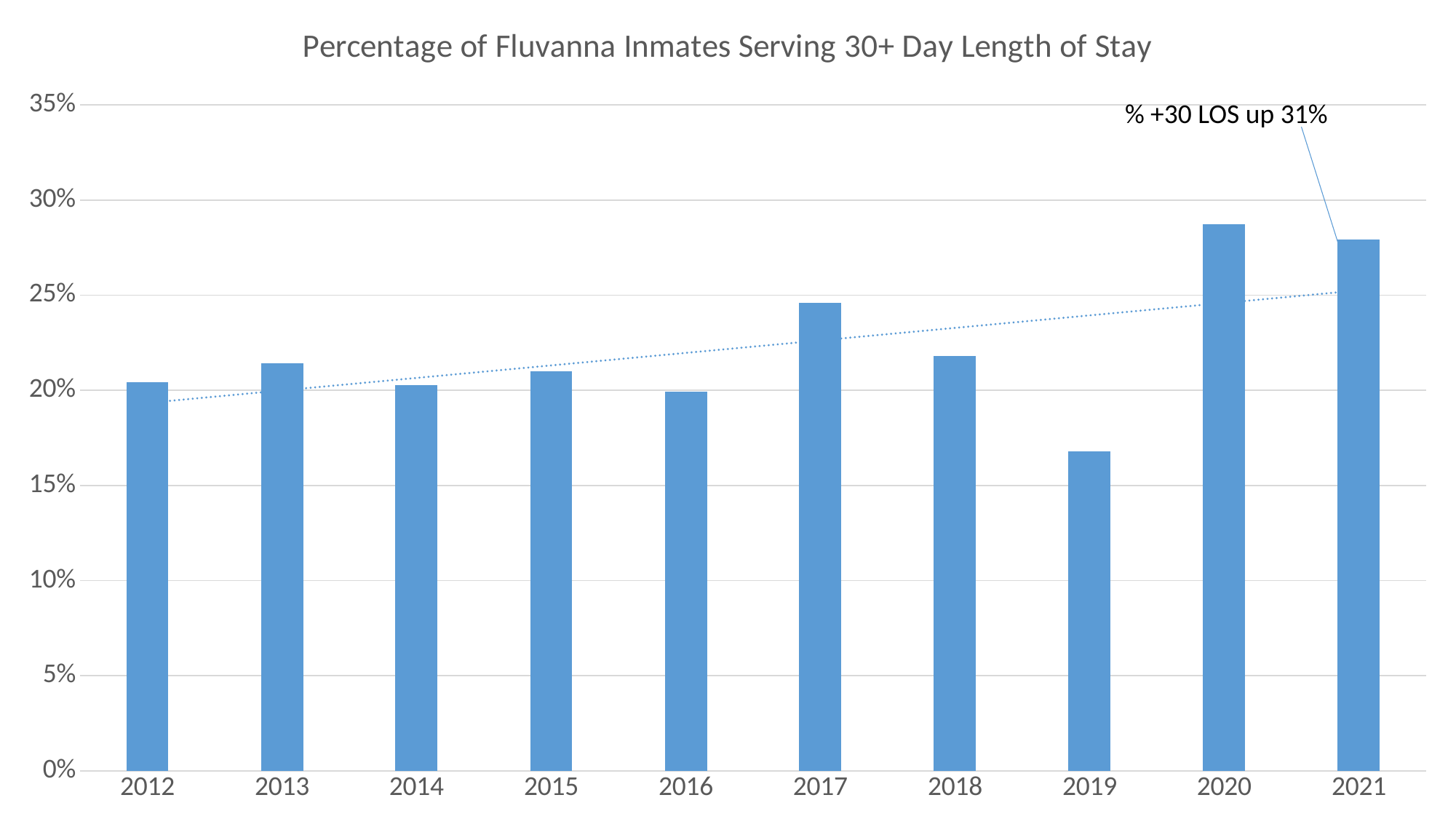
What kind of chart is shown on the slide? bar chart Is the value for 2020 greater or less than 25%? greater Which year has the lowest percentage? 2019 Which year's bar does the annotation "% +30 LOS up 31%" point to? 2021 Is the value for 2017 greater or less than 20%? greater Is the value for 2019 greater or less than 20%? less Does the dotted trend line rise or fall from 2012 to 2021? rises How many years are plotted on the x axis? 10 What is the title of the chart? Percentage of Fluvanna Inmates Serving 30+ Day Length of Stay Which year has the highest percentage? 2020 Which is larger, the value for 2017 or the value for 2018? 2017